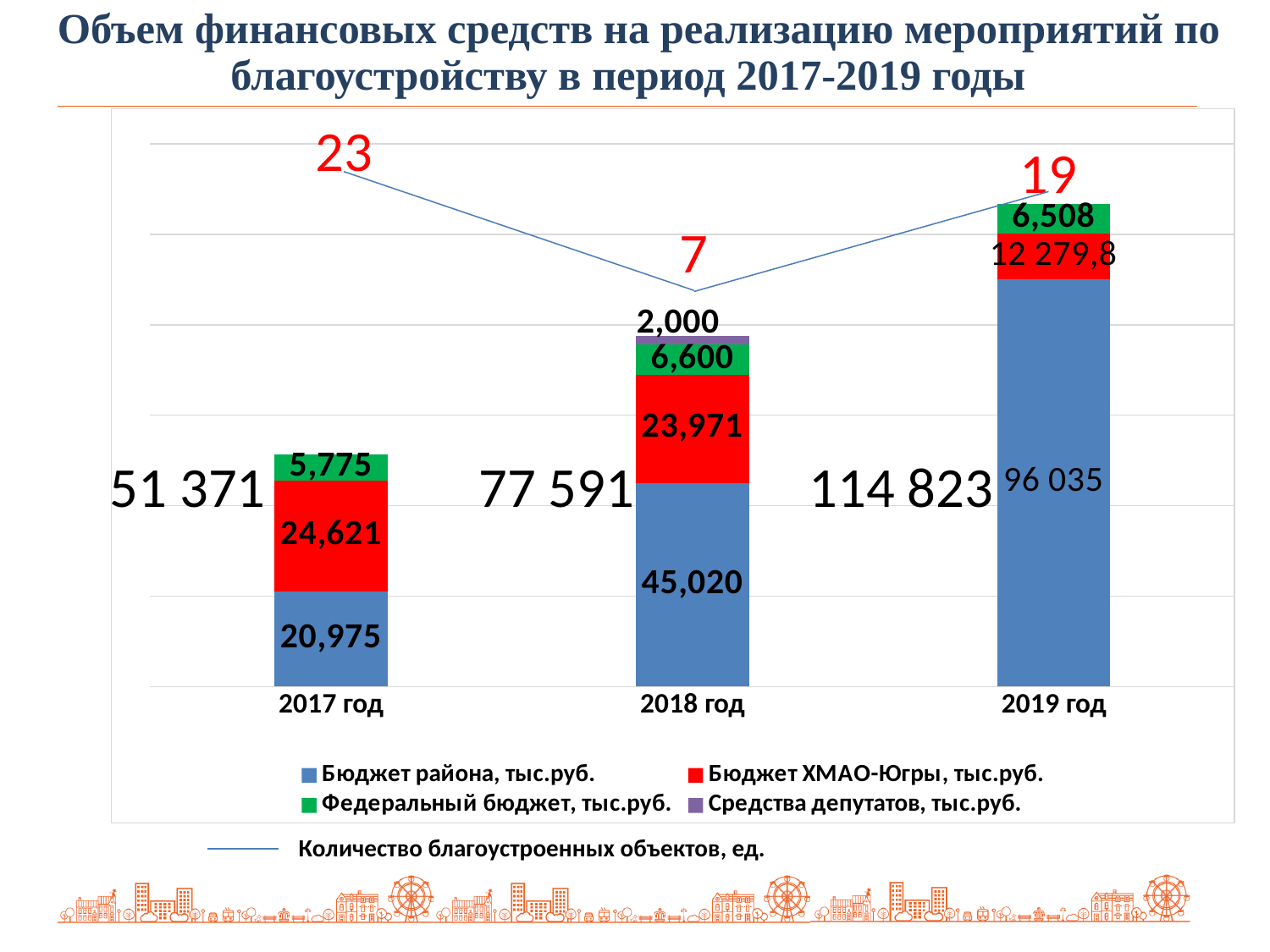
What is the value of Бюджет района, тыс.руб. for 2018 год? 45,020 Which year has the highest value for Бюджет района, тыс.руб.? 2019 год Which year has the lowest value for Количество благоустроенных объектов, ед.? 2018 год What is the value of Количество благоустроенных объектов, ед. for 2017 год? 23 What is the difference between Бюджет района, тыс.руб. for 2018 год and 2017 год? 24,045 What is the value of Бюджет ХМАО-Югры, тыс.руб. for 2017 год? 24,621 What is the value of Средства депутатов, тыс.руб. for 2018 год? 2,000 Does the value of Бюджет района, тыс.руб. rise or fall from 2017 год to 2019 год? rise How many years are shown on the x axis? 3 What is the total of the stacked bar for 2019 год? 114 823 What is the value of Федеральный бюджет, тыс.руб. for 2019 год? 6,508 Which is larger: Бюджет ХМАО-Югры, тыс.руб. for 2018 год or for 2019 год? 2018 год